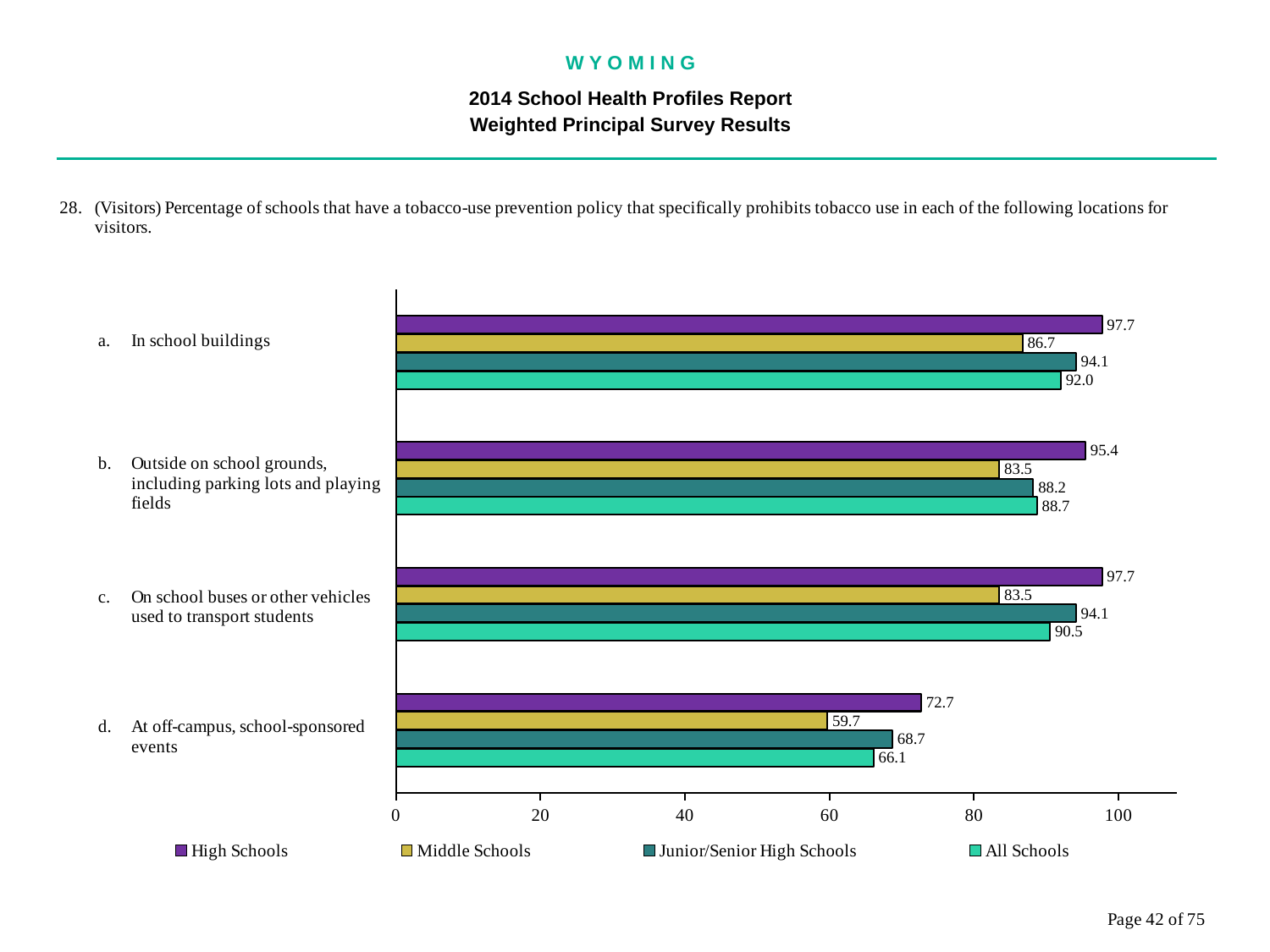
How many locations (categories) are shown on the chart? 4 What is the difference between the High Schools and Middle Schools values for 'At off-campus, school-sponsored events'? 13.0 Which series has the highest value for 'Outside on school grounds, including parking lots and playing fields'? High Schools How many series does the legend list? 4 What kind of chart is shown on the slide? Bar chart What is the value for All Schools for 'On school buses or other vehicles used to transport students'? 90.5 Which location has the lowest value for High Schools? At off-campus, school-sponsored events What is the value for High Schools for 'In school buildings'? 97.7 What is the value for Middle Schools for 'At off-campus, school-sponsored events'? 59.7 Is the value for All Schools for 'At off-campus, school-sponsored events' greater or less than 80? less Which is larger for 'In school buildings': the Junior/Senior High Schools value or the All Schools value? Junior/Senior High Schools What is the value for Junior/Senior High Schools for 'Outside on school grounds, including parking lots and playing fields'? 88.2